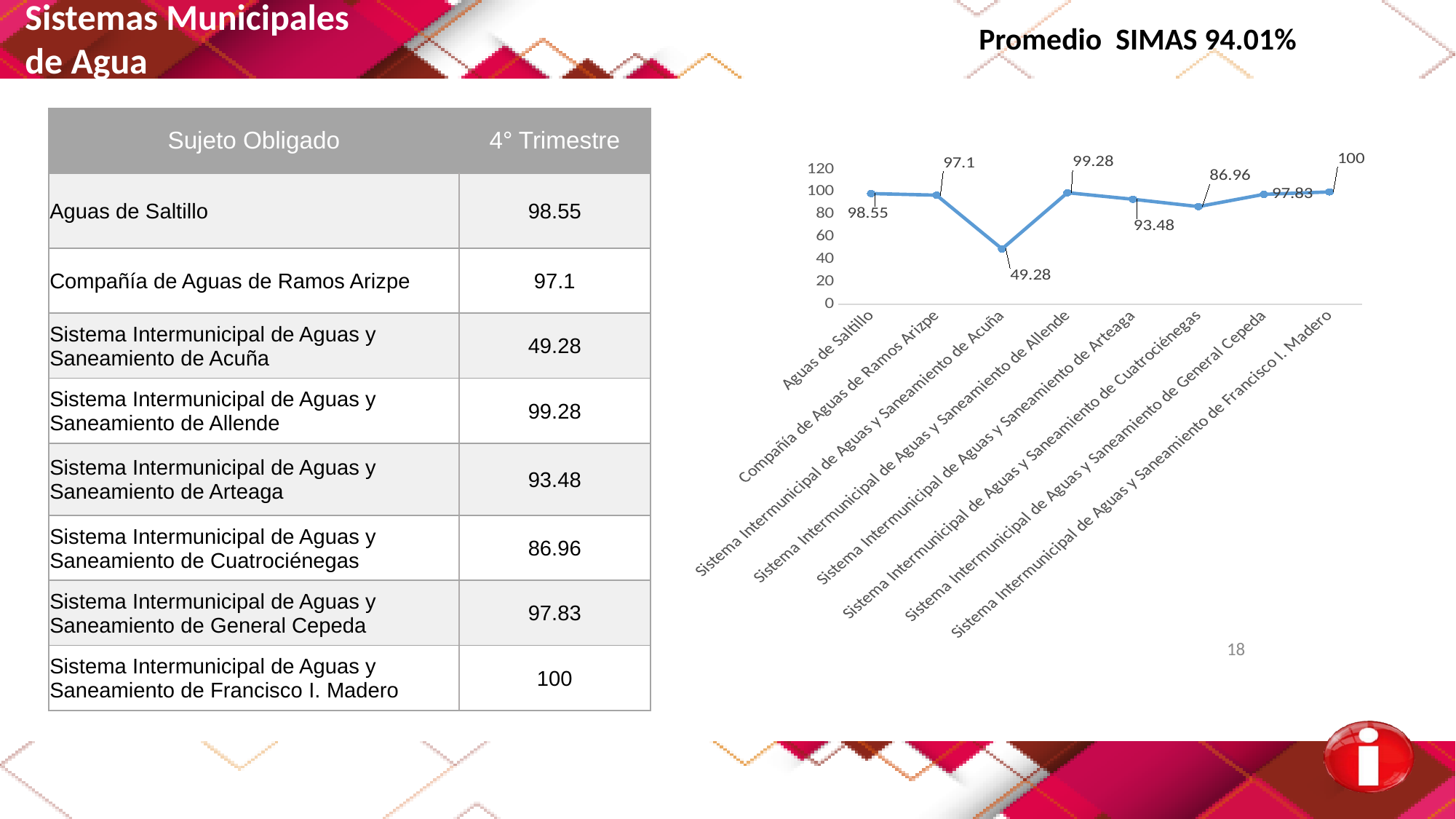
What is the difference between the values for Sistema Intermunicipal de Aguas y Saneamiento de General Cepeda and Sistema Intermunicipal de Aguas y Saneamiento de Cuatrociénegas? 10.87 How many categories are plotted in the chart? 8 What is the difference between the values for Sistema Intermunicipal de Aguas y Saneamiento de Allende and Sistema Intermunicipal de Aguas y Saneamiento de Acuña? 50 Which is larger, the value for Compañía de Aguas de Ramos Arizpe or the value for Sistema Intermunicipal de Aguas y Saneamiento de Arteaga? Compañía de Aguas de Ramos Arizpe What type of chart is shown on the slide? line chart Is the value for Sistema Intermunicipal de Aguas y Saneamiento de Acuña greater or less than 60? less Which category has the lowest value in the chart? Sistema Intermunicipal de Aguas y Saneamiento de Acuña What is the value for Aguas de Saltillo in the chart? 98.55 Which category has the highest value in the chart? Sistema Intermunicipal de Aguas y Saneamiento de Francisco I. Madero What is the value for Sistema Intermunicipal de Aguas y Saneamiento de Cuatrociénegas in the chart? 86.96 What is the highest value shown on the vertical axis of the chart? 120 What is the value for Sistema Intermunicipal de Aguas y Saneamiento de Acuña in the chart? 49.28